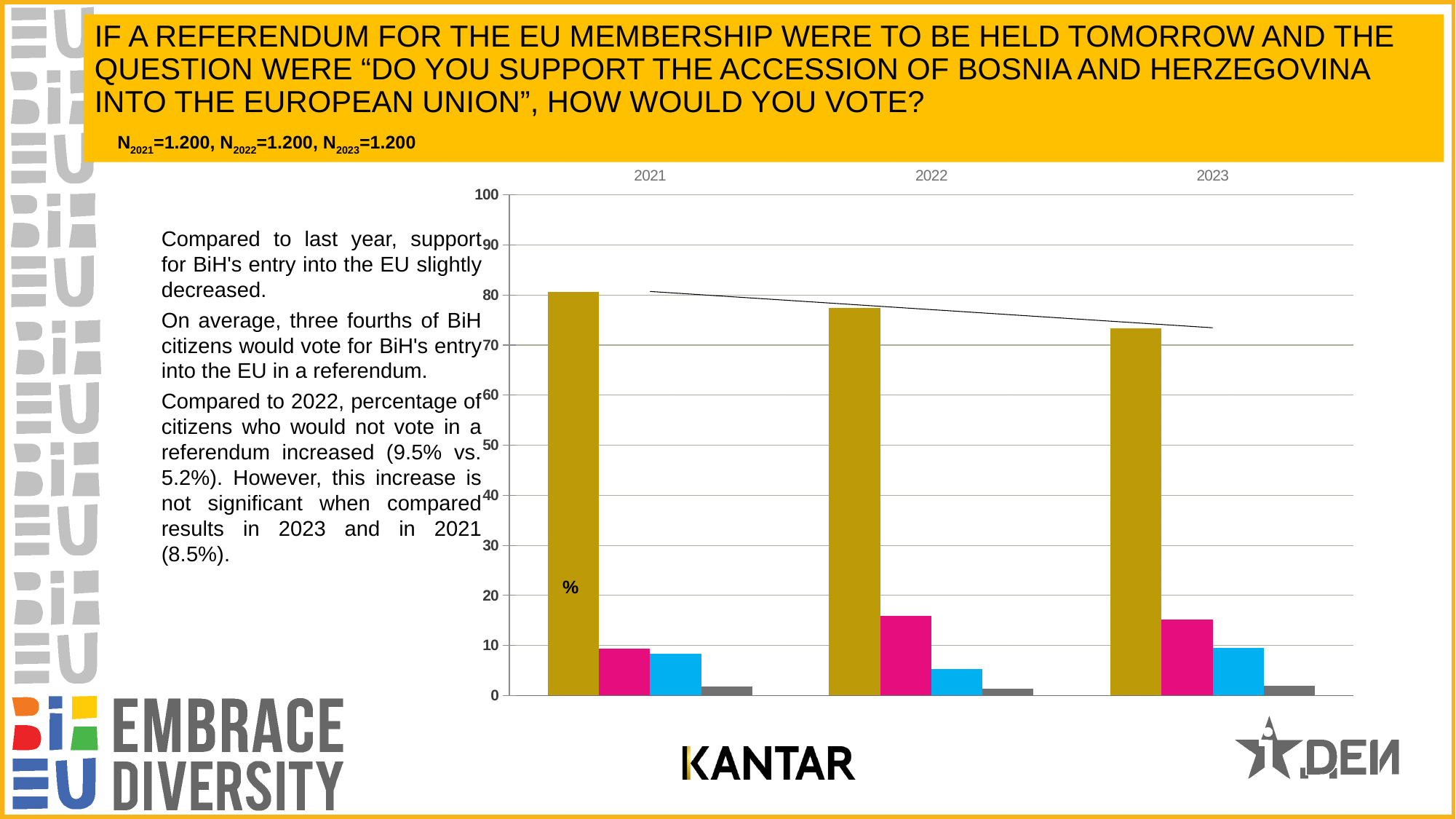
What kind of chart is shown on the slide? bar chart Which is larger in 2022, the pink bar or the blue bar? the pink bar Do the tallest (gold) bars rise or fall from 2021 to 2023? fall Which years are shown as categories on the chart? 2021, 2022, 2023 In which year is the tallest (gold) bar the highest? 2021 Is the tallest (gold) bar for 2023 greater or less than 80? less How many years (categories) are shown on the x axis of the chart? 3 Which is larger, the gold bar for 2021 or the gold bar for 2023? 2021 How many bars are shown for each year on the chart? 4 Is the pink bar for 2022 greater or less than 10? greater Is the blue bar for 2022 greater or less than 10? less